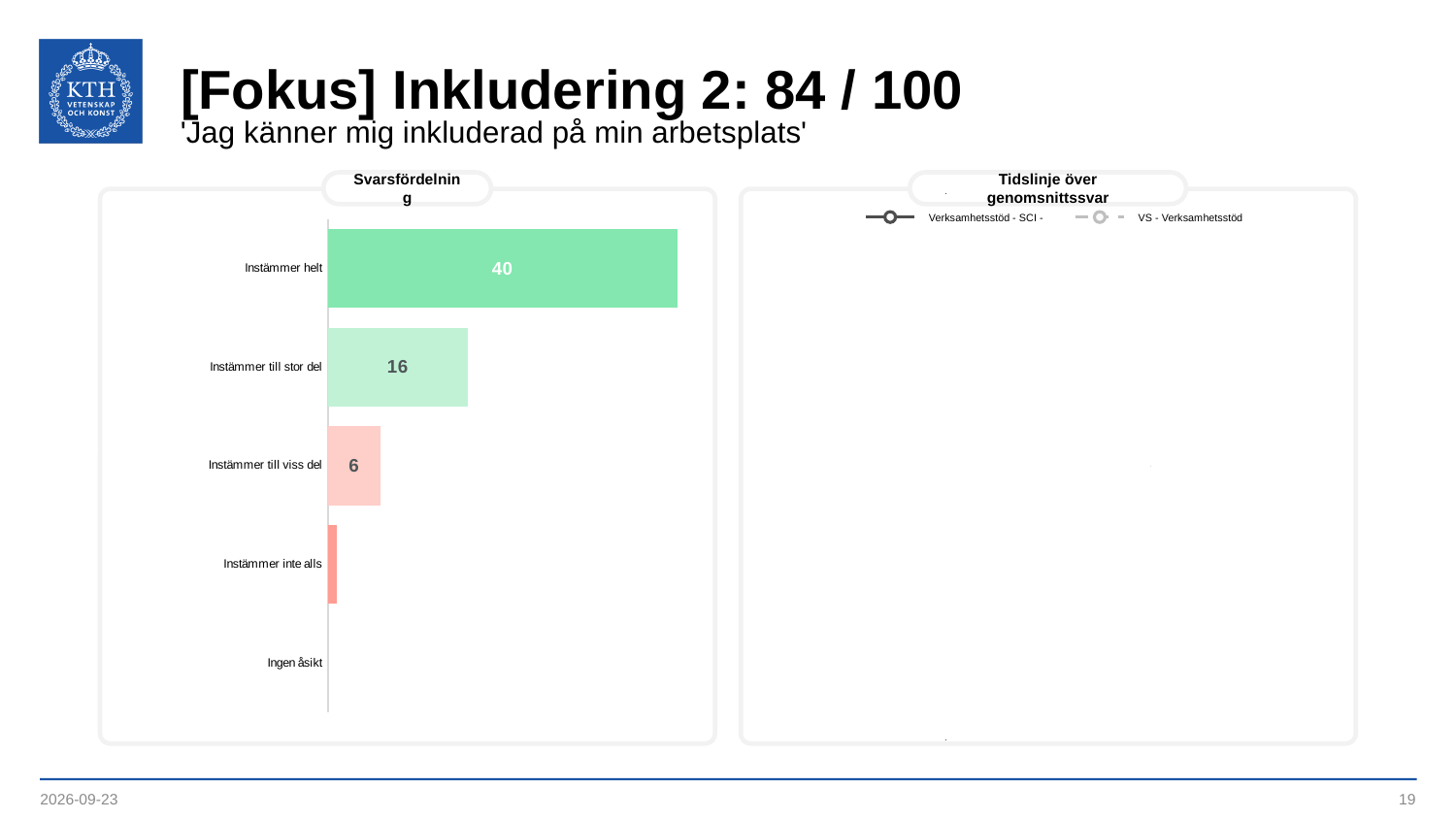
In the Svarsfördelning chart, what is the value for 'Instämmer helt'? 40 In the Svarsfördelning chart, what is the difference between 'Instämmer helt' and 'Instämmer till stor del'? 24 What is the title of the chart on the left side of the slide? Svarsfördelning In the Svarsfördelning chart, what is the difference between 'Instämmer till stor del' and 'Instämmer till viss del'? 10 In the Svarsfördelning chart, what is the value for 'Instämmer till viss del'? 6 In the Svarsfördelning chart, which category has the highest value? Instämmer helt How many series does the legend of the 'Tidslinje över genomsnittssvar' chart list? 2 In the Svarsfördelning chart, which is larger: 'Instämmer till viss del' or 'Instämmer inte alls'? Instämmer till viss del How many categories are shown in the Svarsfördelning chart? 5 In the Svarsfördelning chart, what is the value for 'Instämmer till stor del'? 16 In the Svarsfördelning chart, which is larger: 'Instämmer till stor del' or 'Instämmer till viss del'? Instämmer till stor del What kind of chart is the Svarsfördelning chart? Bar chart